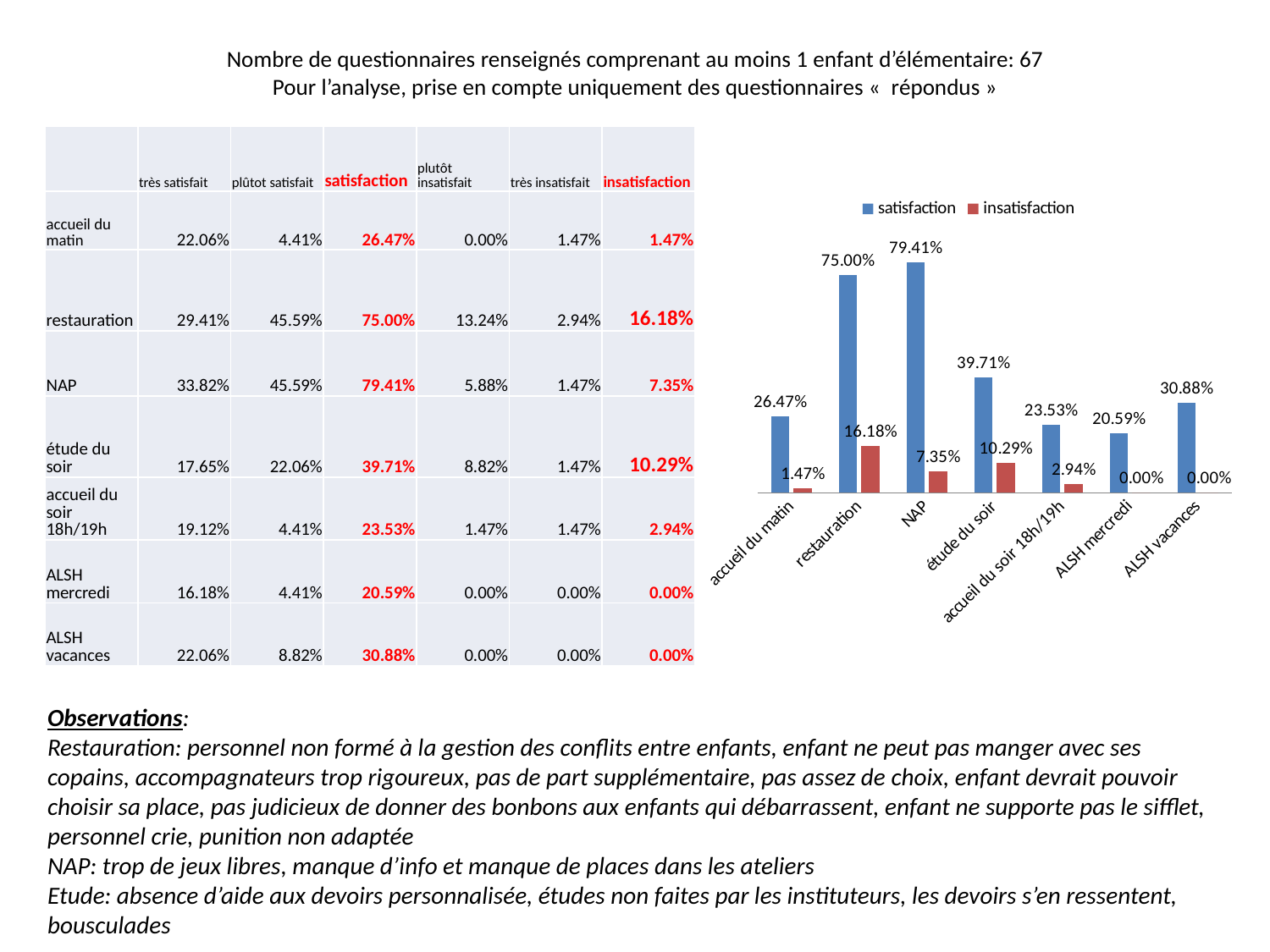
What type of chart is shown on the slide? bar chart How many series does the chart legend list? 2 Which category has the highest insatisfaction value in the chart? restauration What is the satisfaction value for ALSH vacances in the chart? 30.88% Which is larger: the satisfaction value for étude du soir or for accueil du matin? étude du soir What is the satisfaction value for NAP in the chart? 79.41% What is the difference between the satisfaction values for NAP and restauration? 4.41% Which category has the lowest satisfaction value in the chart? ALSH mercredi Which category has the highest satisfaction value in the chart? NAP What are the two series named in the chart legend? satisfaction and insatisfaction What is the insatisfaction value for restauration in the chart? 16.18% How many categories are shown on the x axis of the chart? 7